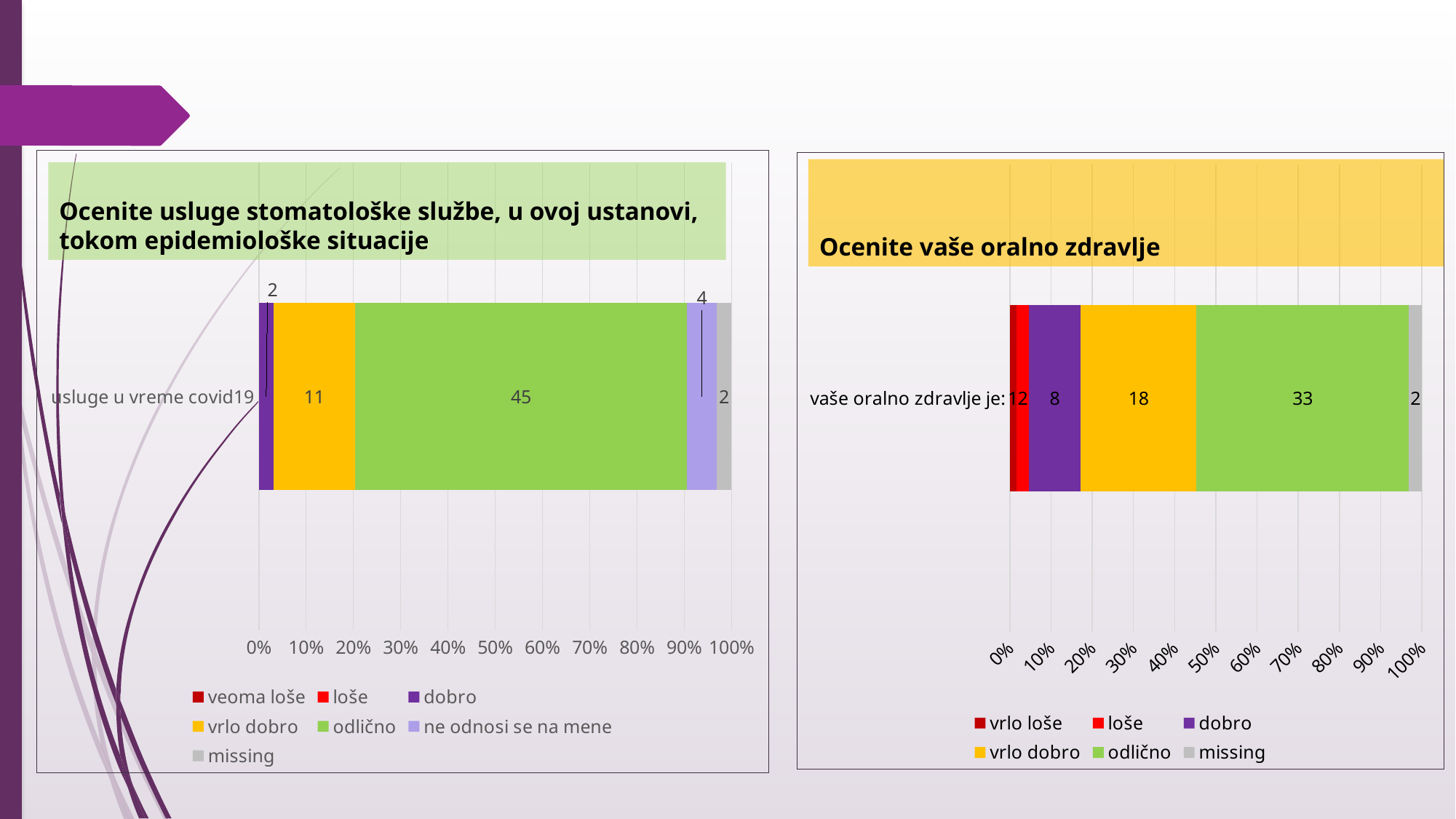
In the left chart (Ocenite usluge stomatološke službe), what is the value for ne odnosi se na mene? 4 How many series does the legend of the right chart (Ocenite vaše oralno zdravlje) list? 6 In the left chart (Ocenite usluge stomatološke službe), what is the value for odlično? 45 What kind of chart is the right chart (Ocenite vaše oralno zdravlje)? Stacked bar chart In the left chart (Ocenite usluge stomatološke službe), what is the difference between the values for odlično and vrlo dobro? 34 In the right chart (Ocenite vaše oralno zdravlje), which is larger, the value for dobro or the value for vrlo dobro? vrlo dobro In the right chart (Ocenite vaše oralno zdravlje), which series has the highest value? odlično In the right chart (Ocenite vaše oralno zdravlje), what is the value for vrlo dobro? 18 How many series does the legend of the left chart (Ocenite usluge stomatološke službe) list? 7 In the left chart (Ocenite usluge stomatološke službe), what is the value for vrlo dobro? 11 In the left chart (Ocenite usluge stomatološke službe), which series has the highest value? odlično In the right chart (Ocenite vaše oralno zdravlje), what is the value for odlično? 33